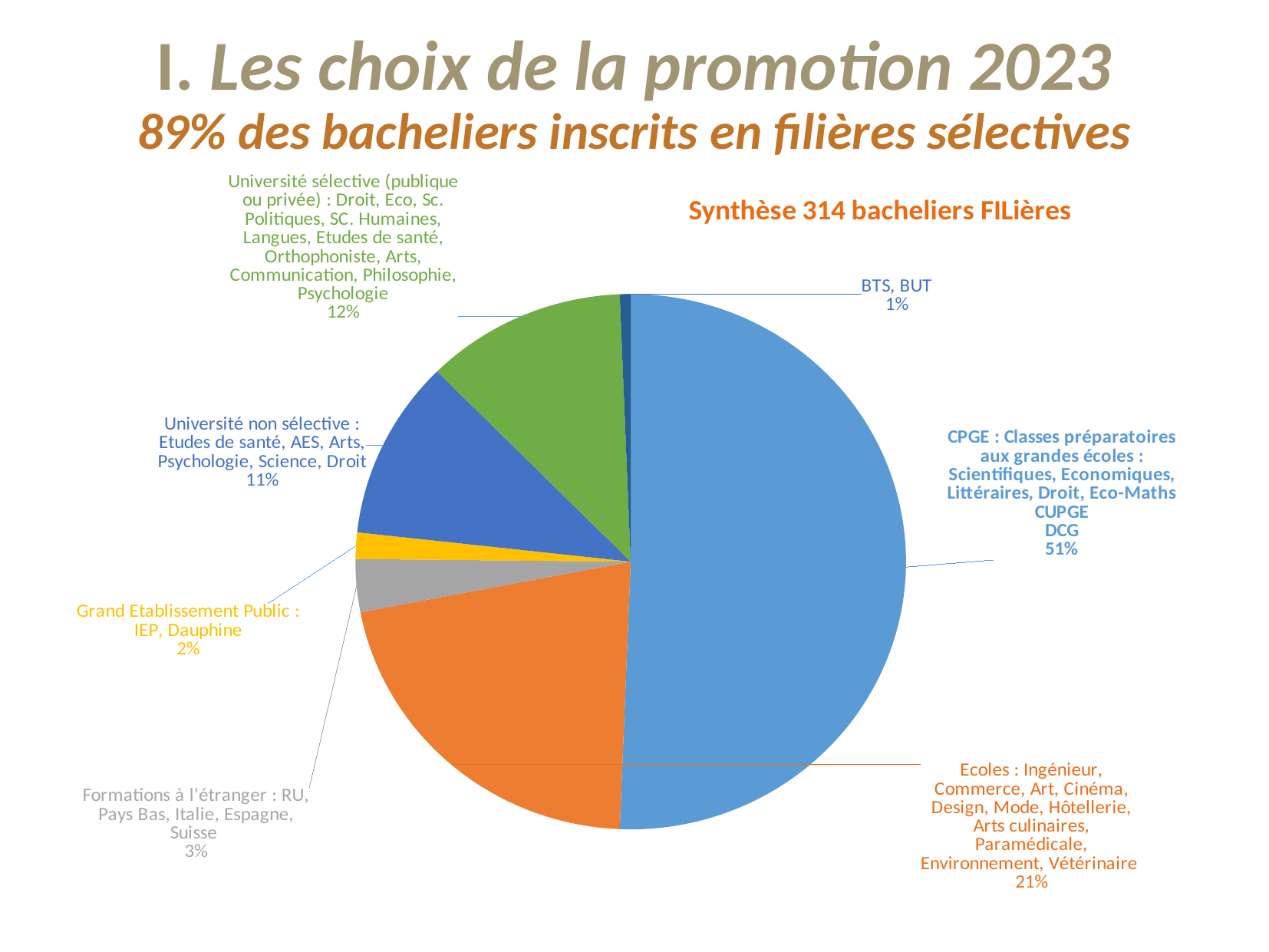
What percentage is shown for Université sélective (publique ou privée)? 12% What share of the pie is CPGE (Classes préparatoires aux grandes écoles)? 51% What kind of chart is shown on the slide? Pie chart What percentage is shown for Université non sélective? 11% Which is larger, the share for Grand Etablissement Public (IEP, Dauphine) or the share for Formations à l'étranger? Formations à l'étranger What is the difference in percentage points between CPGE (51%) and Ecoles (21%)? 30 How many slices does the pie chart have? 7 What is the title of the chart? Synthèse 314 bacheliers FILières What percentage is shown for Ecoles (Ingénieur, Commerce, Art, Cinéma, Design, Mode, Hôtellerie...)? 21% What percentage is shown for Formations à l'étranger (RU, Pays Bas, Italie, Espagne, Suisse)? 3% Which category has the largest share of the pie? CPGE : Classes préparatoires aux grandes écoles Which category has the smallest share of the pie? BTS, BUT